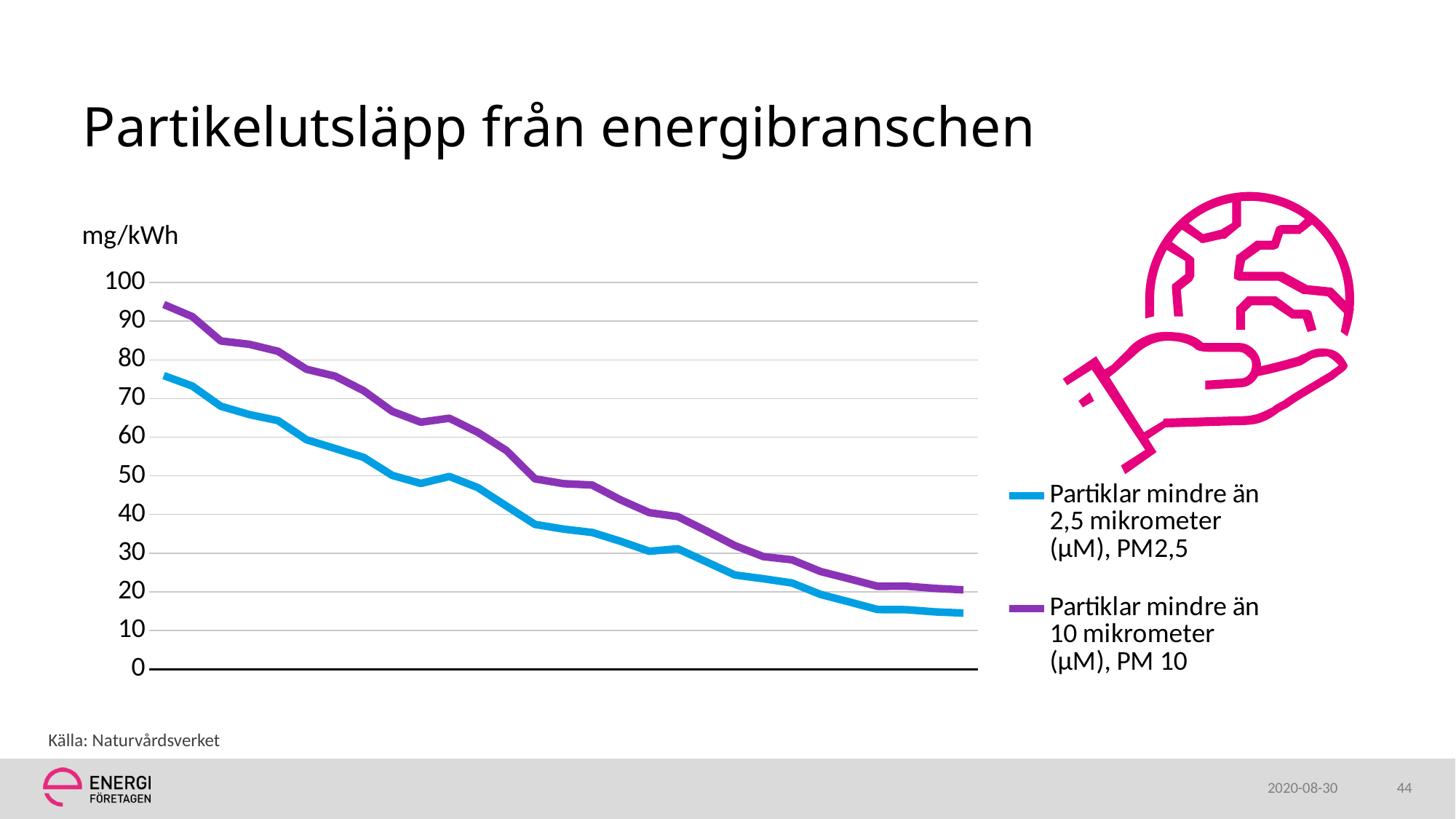
Is the final value of the 'Partiklar mindre än 2,5 mikrometer (µM), PM2,5' line greater or less than 20? less Is the starting value of the 'Partiklar mindre än 2,5 mikrometer (µM), PM2,5' line greater or less than 80? less What unit is shown on the y axis of the chart? mg/kWh What is the title of the slide containing the chart? Partikelutsläpp från energibranschen Which series has the higher values throughout the chart, PM2,5 or PM 10? PM 10 Do the values for 'Partiklar mindre än 2,5 mikrometer (µM), PM2,5' rise or fall along the x axis? fall Is the final value of the 'Partiklar mindre än 10 mikrometer (µM), PM 10' line greater or less than 30? less How many series does the legend list? 2 Do the values for 'Partiklar mindre än 10 mikrometer (µM), PM 10' rise or fall along the x axis? fall What kind of chart is shown on the slide? line chart